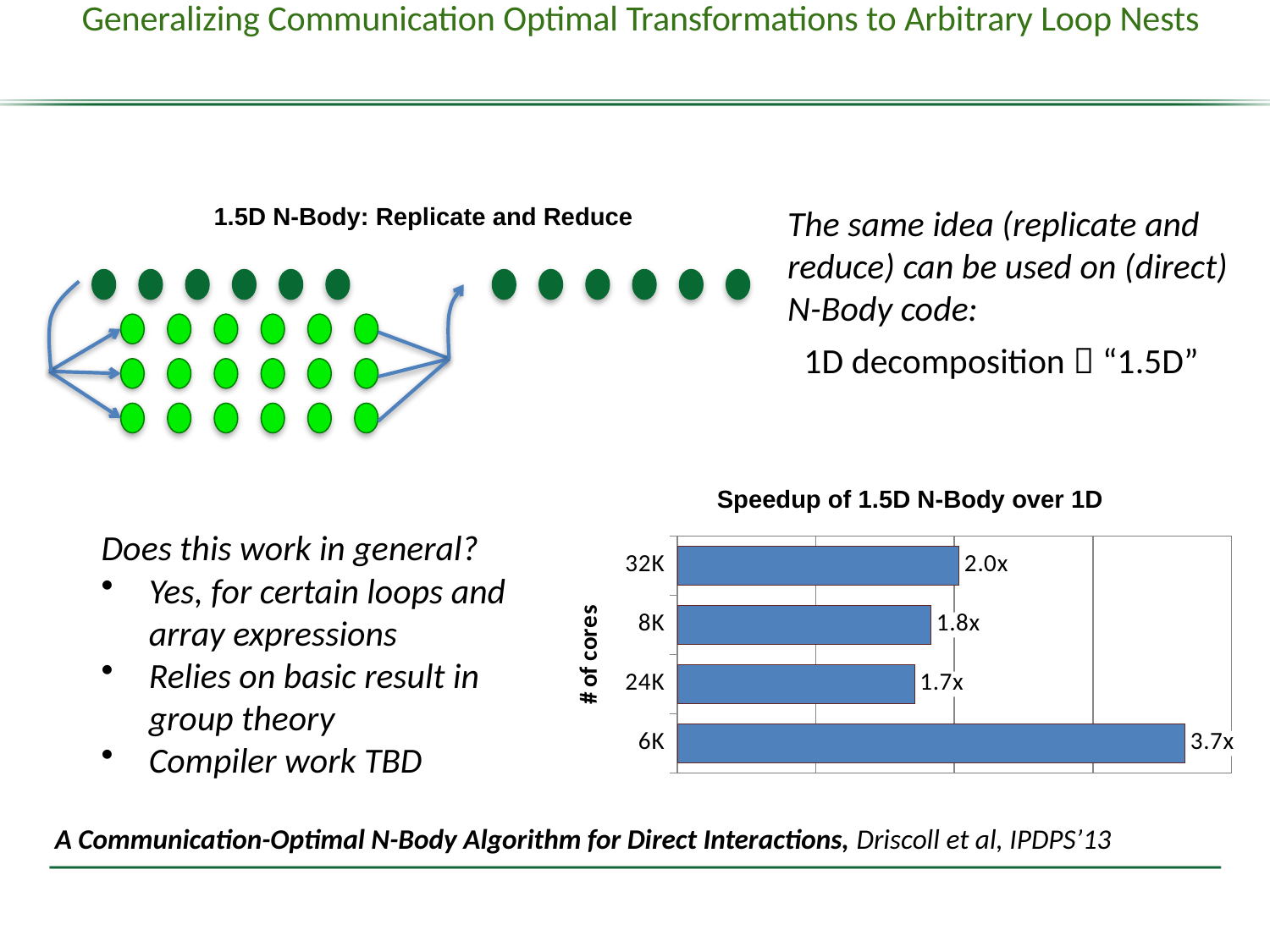
What is the speedup for 8K cores in the 'Speedup of 1.5D N-Body over 1D' chart? 1.8x What type of chart is 'Speedup of 1.5D N-Body over 1D'? Bar chart What is the speedup for 6K cores in the 'Speedup of 1.5D N-Body over 1D' chart? 3.7x What is the speedup for 24K cores in the 'Speedup of 1.5D N-Body over 1D' chart? 1.7x In the 'Speedup of 1.5D N-Body over 1D' chart, what is the difference between the speedup at 6K cores and at 32K cores? 1.7x Which core count has the highest speedup in the 'Speedup of 1.5D N-Body over 1D' chart? 6K How many core counts are plotted in the 'Speedup of 1.5D N-Body over 1D' chart? 4 Which core count has the lowest speedup in the 'Speedup of 1.5D N-Body over 1D' chart? 24K What is the speedup for 32K cores in the 'Speedup of 1.5D N-Body over 1D' chart? 2.0x What is the label on the vertical axis of the 'Speedup of 1.5D N-Body over 1D' chart? # of cores In the 'Speedup of 1.5D N-Body over 1D' chart, what is the difference between the speedup at 32K cores and at 8K cores? 0.2x In the 'Speedup of 1.5D N-Body over 1D' chart, which has the larger speedup: 32K cores or 8K cores? 32K